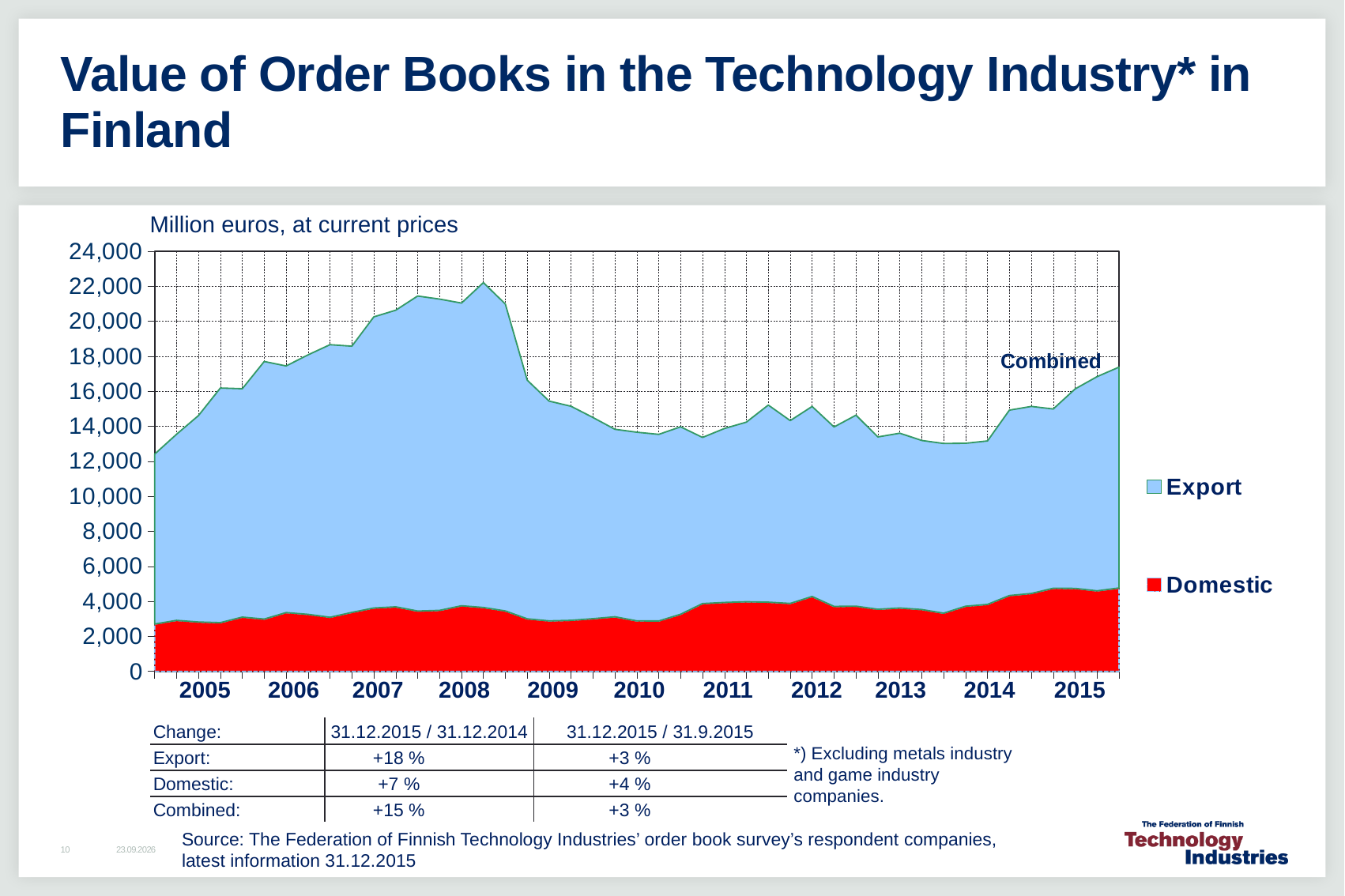
In which year does the combined value of order books reach its highest point? 2008 Is the combined value at its 2008 peak greater or less than 20,000? greater Which is larger, the combined value in 2007 or in 2013? 2007 What kind of chart is shown on the slide? area chart How many series does the legend list? 2 Is the Domestic value at the start of 2005 greater or less than 4,000? less What unit is stated above the y axis? Million euros, at current prices Is the combined value in 2010 greater or less than 16,000? less Does the combined value rise or fall between its 2008 peak and 2009? fall What are the two series named in the legend? Export and Domestic How many years are labelled on the x axis? 11 According to the change table, what is the Export change for 31.12.2015 / 31.12.2014? +18 %